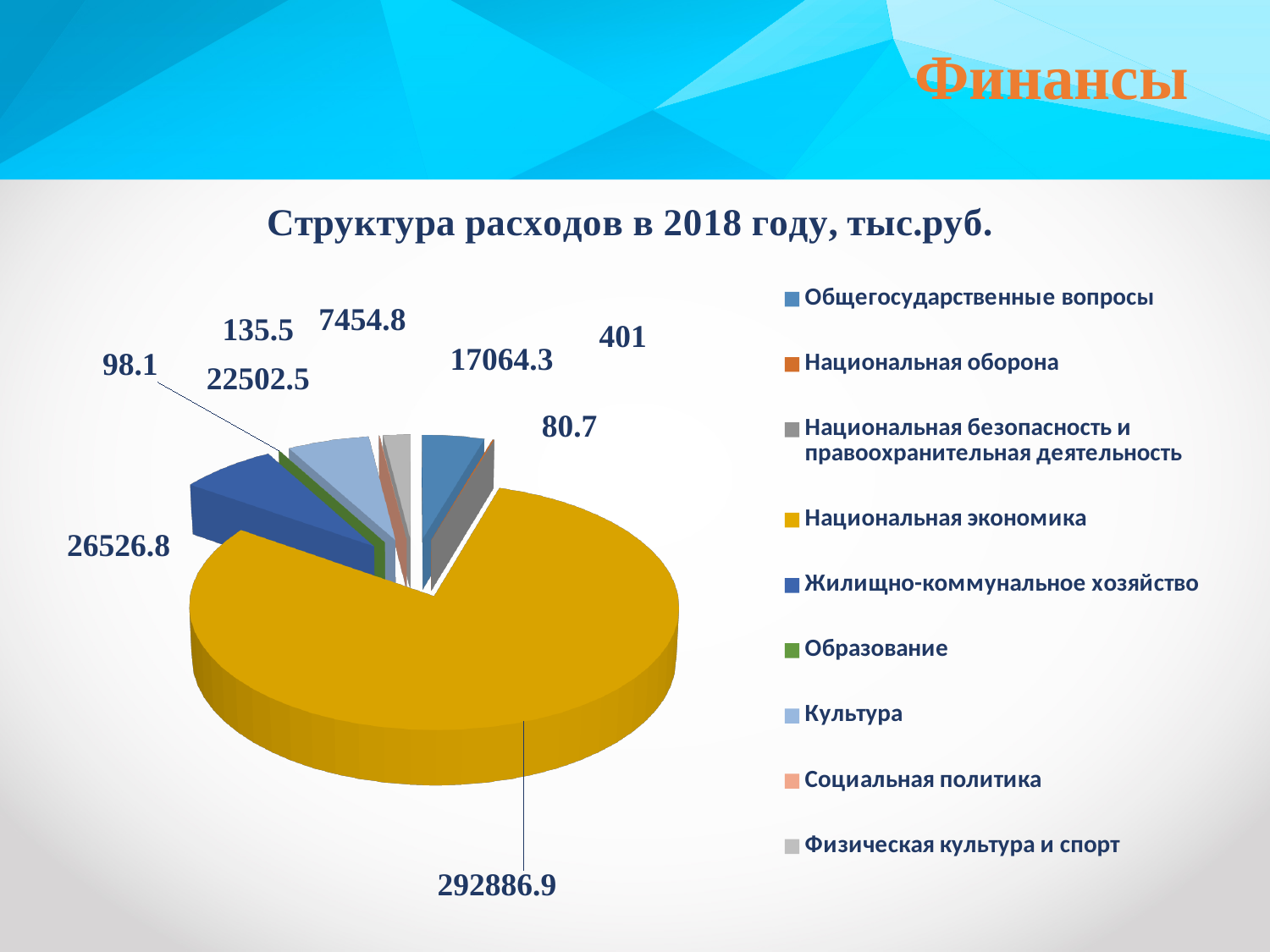
Which is larger, the value for Жилищно-коммунальное хозяйство or the value for Культура? Жилищно-коммунальное хозяйство What is the value for Жилищно-коммунальное хозяйство? 26526.8 How many categories does the legend of the pie chart list? 9 Which category has the largest slice in the pie chart? Национальная экономика What kind of chart is shown on the slide? pie chart What is the smallest value labelled on the pie chart? 80.7 What is the value for Общегосударственные вопросы? 17064.3 What is the difference between the values for Жилищно-коммунальное хозяйство and Культура? 4024.3 How many slices does the pie chart have? 9 What is the value for Национальная экономика? 292886.9 What is the value for Культура? 22502.5 What is the title of the chart? Структура расходов в 2018 году, тыс.руб.